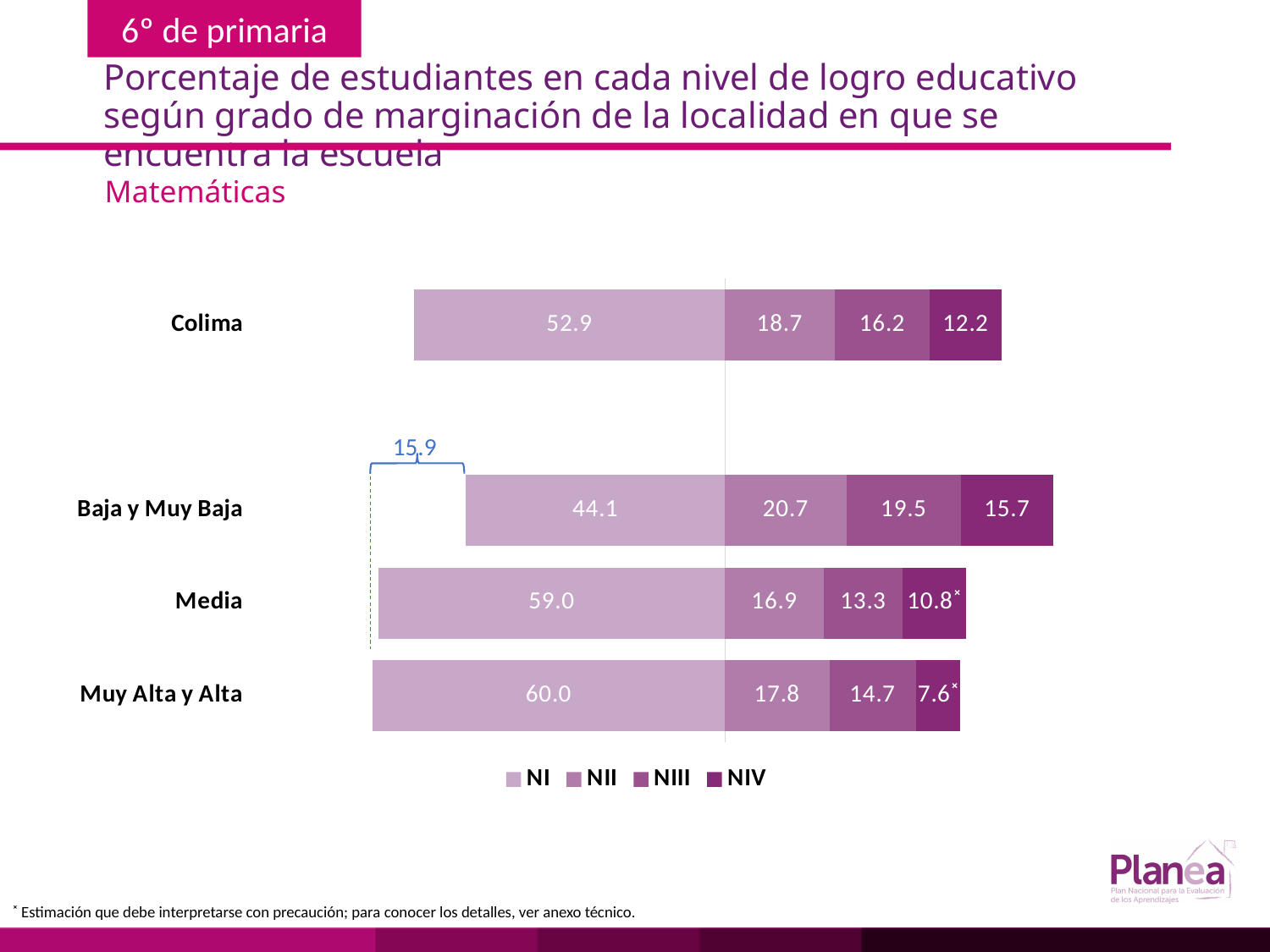
What is the total of the stacked bar for Colima? 100.0 What is the difference between the NI values for Media and Baja y Muy Baja? 14.9 How many categories are shown on the chart? 4 What kind of chart is shown on the slide? Stacked bar chart What is the NIII value for Muy Alta y Alta? 14.7 What is the NIV value for Baja y Muy Baja? 15.7 What is the NII value for Media? 16.9 Which category has the highest NI value? Muy Alta y Alta Which category has the lowest NIV value? Muy Alta y Alta What is the NI value for Colima? 52.9 Which is larger, the NIII value for Colima or the NIII value for Media? Colima How many series does the legend list? 4